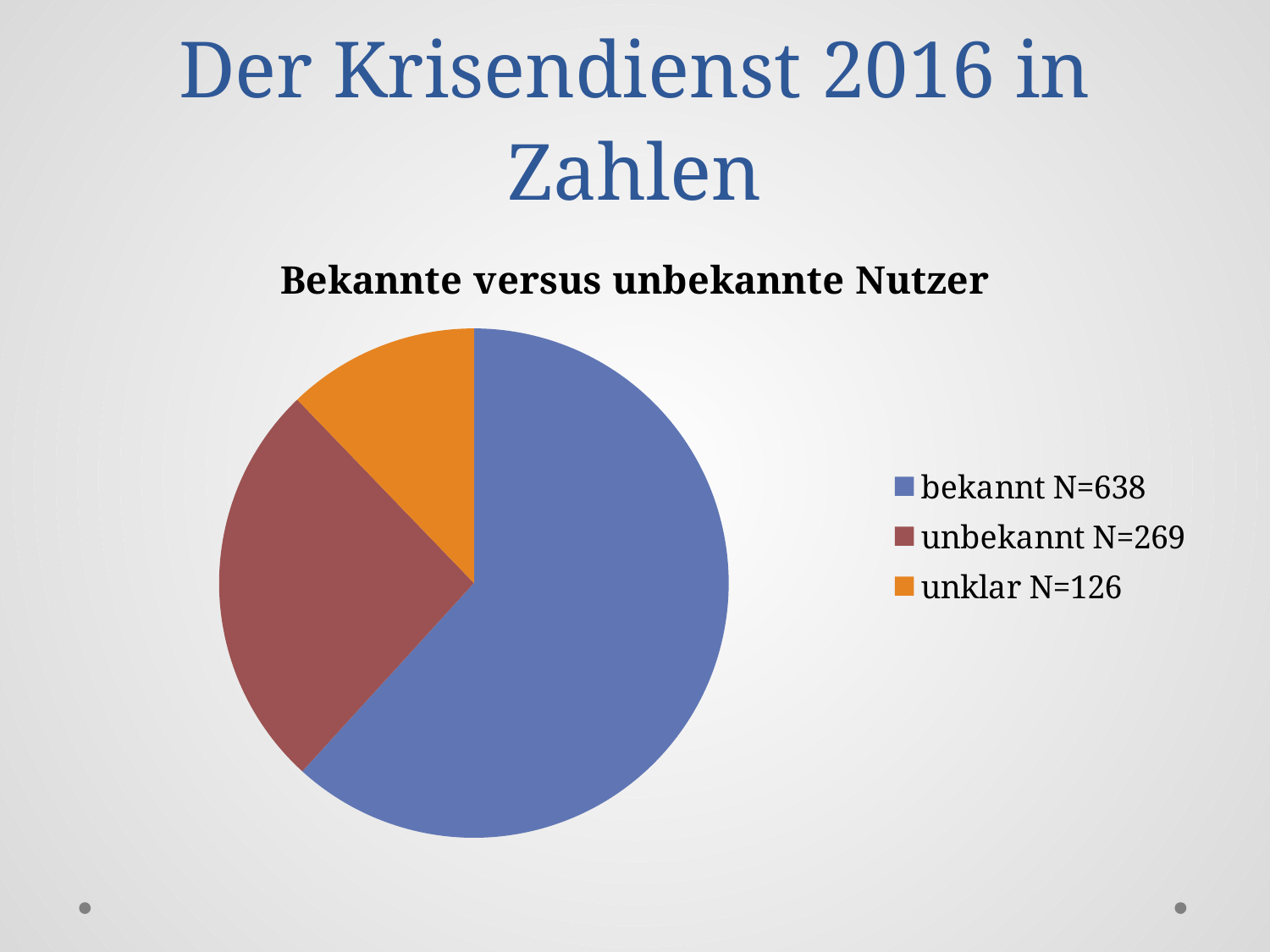
What is the difference between the values for "bekannt" and "unbekannt"? 369 What is the title of the chart? Bekannte versus unbekannte Nutzer Which is larger, the value for "unbekannt" or the value for "unklar"? unbekannt What type of chart is shown on the slide? pie chart How many slices does the pie chart have? 3 What is the value (N) for the category "unklar"? 126 What is the value (N) for the category "bekannt"? 638 What is the value (N) for the category "unbekannt"? 269 What is the difference between the values for "unbekannt" and "unklar"? 143 Which category has the largest slice of the pie? bekannt What colour is the slice for "unklar"? orange Which category has the smallest slice of the pie? unklar